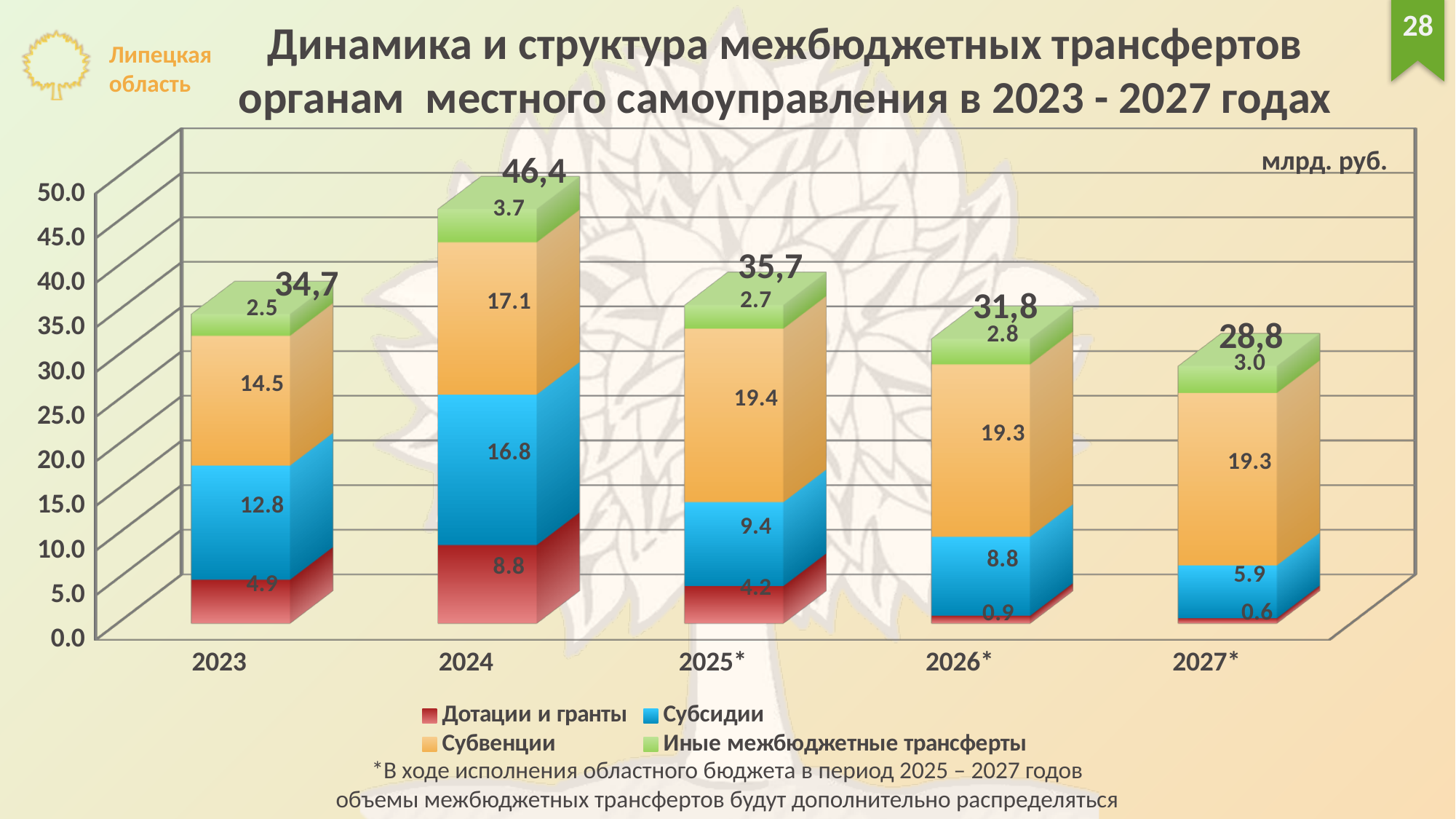
How many series does the chart legend list? 4 What is the value of Дотации и гранты for 2027*? 0.6 Which year has the highest total of intergovernmental transfers? 2024 How many years (categories) are shown on the x axis of the chart? 5 Which year has the lowest total of intergovernmental transfers? 2027* What is the value of Субсидии for 2024? 16.8 What is the total of the stacked bar for 2024? 46,4 Which is larger: Иные межбюджетные трансферты in 2024 or in 2023? 2024 What type of chart is shown on the slide? Stacked bar chart Do the total values rise or fall from 2024 to 2027*? Fall What is the difference between the Субсидии values for 2024 and 2025*? 7.4 What is the value of Субвенции for 2025*? 19.4